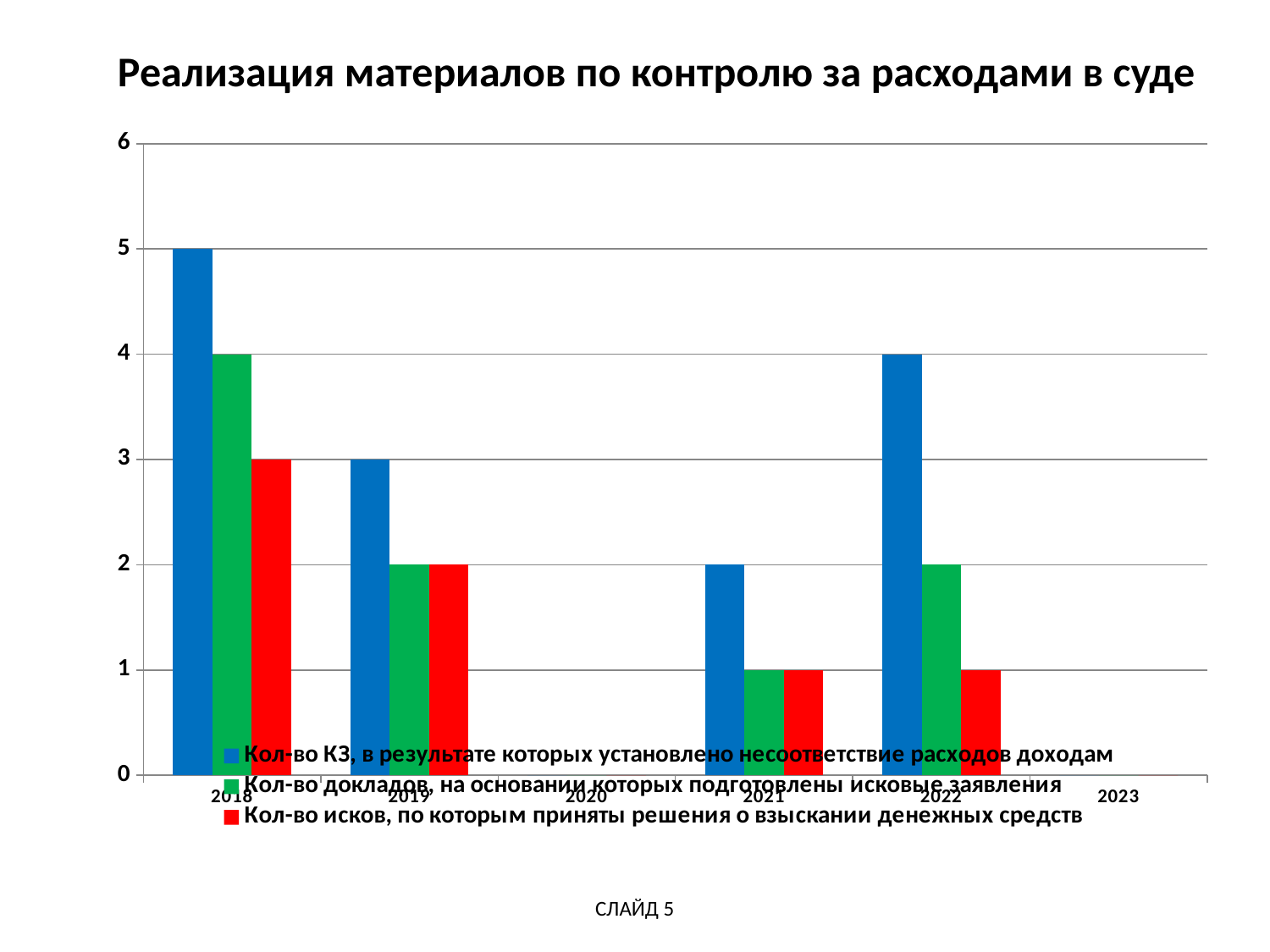
How many years are shown on the x axis? 6 What kind of chart is shown on the slide? Bar chart How many series does the legend list? 3 Does the red series (Кол-во исков) rise or fall from 2018 to 2021? Fall Which is larger: the green series value for 2018 or the green series value for 2022? 2018 In which year does the blue series (Кол-во КЗ) reach its highest value? 2018 What is the value of the blue series (Кол-во КЗ, в результате которых установлено несоответствие расходов доходам) for 2018? 5 What is the difference between the blue series value for 2018 and the blue series value for 2022? 1 What is the value of the red series (Кол-во исков, по которым приняты решения о взыскании денежных средств) for 2022? 1 What is the title of the chart? Реализация материалов по контролю за расходами в суде Among the years with visible bars, in which year is the blue series (Кол-во КЗ) lowest? 2021 What is the value of the green series (Кол-во докладов, на основании которых подготовлены исковые заявления) for 2019? 2